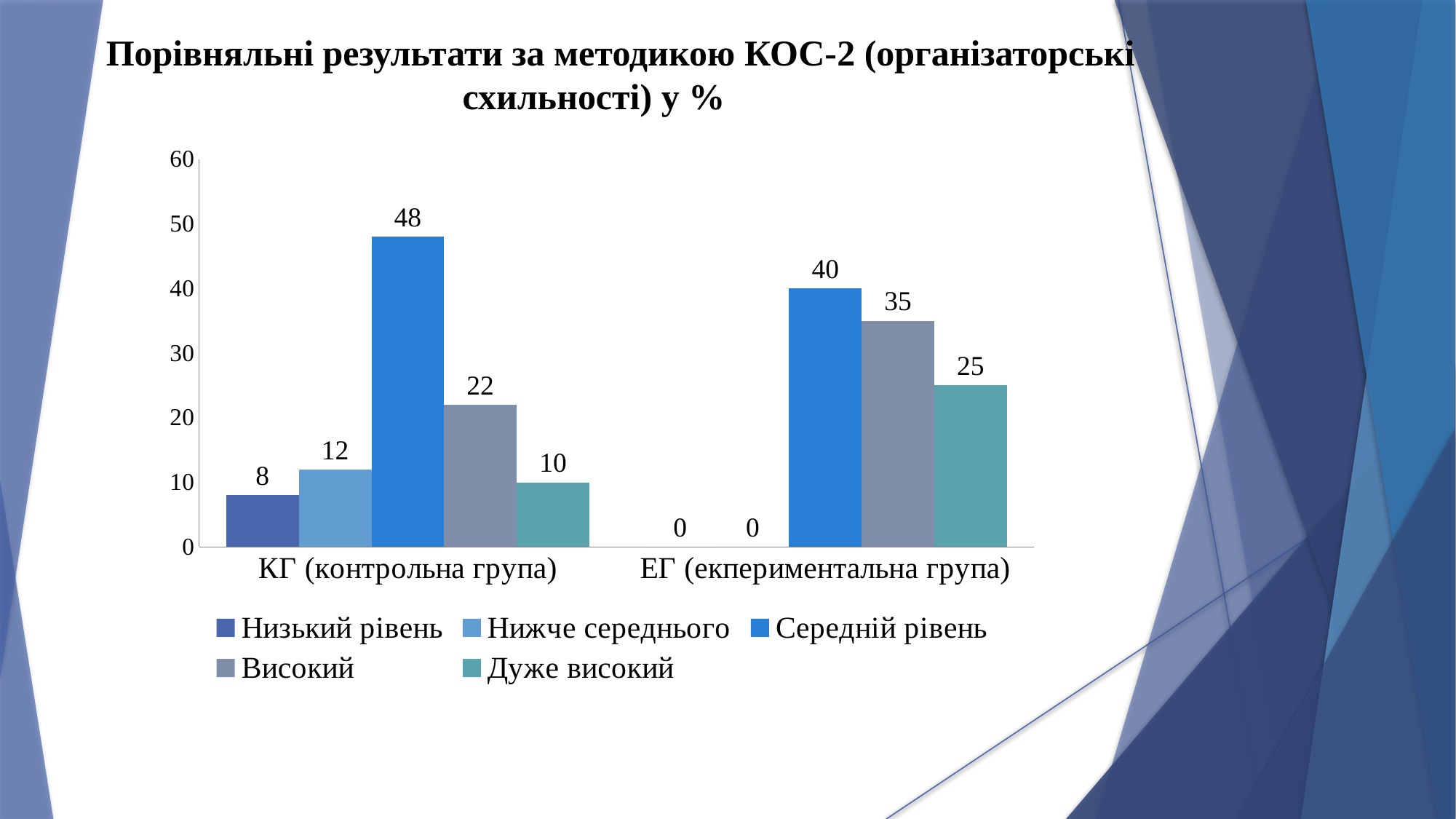
What is the title of the chart? Порівняльні результати за методикою КОС-2 (організаторські схильності) у % Which series has the lowest value in the КГ (контрольна група) category? Низький рівень What is the value for Низький рівень in the ЕГ (екпериментальна група) category? 0 How many categories are shown on the x axis? 2 What is the difference between the Високий values for ЕГ (екпериментальна група) and КГ (контрольна група)? 13 How many series does the legend list? 5 Which is larger: Дуже високий for КГ (контрольна група) or Дуже високий for ЕГ (екпериментальна група)? ЕГ (екпериментальна група) What is the value for Високий in the ЕГ (екпериментальна група) category? 35 What is the value for Середній рівень in the КГ (контрольна група) category? 48 What is the difference between the Середній рівень values for КГ (контрольна група) and ЕГ (екпериментальна група)? 8 Which series has the highest value in the КГ (контрольна група) category? Середній рівень What kind of chart is shown on the slide? bar chart